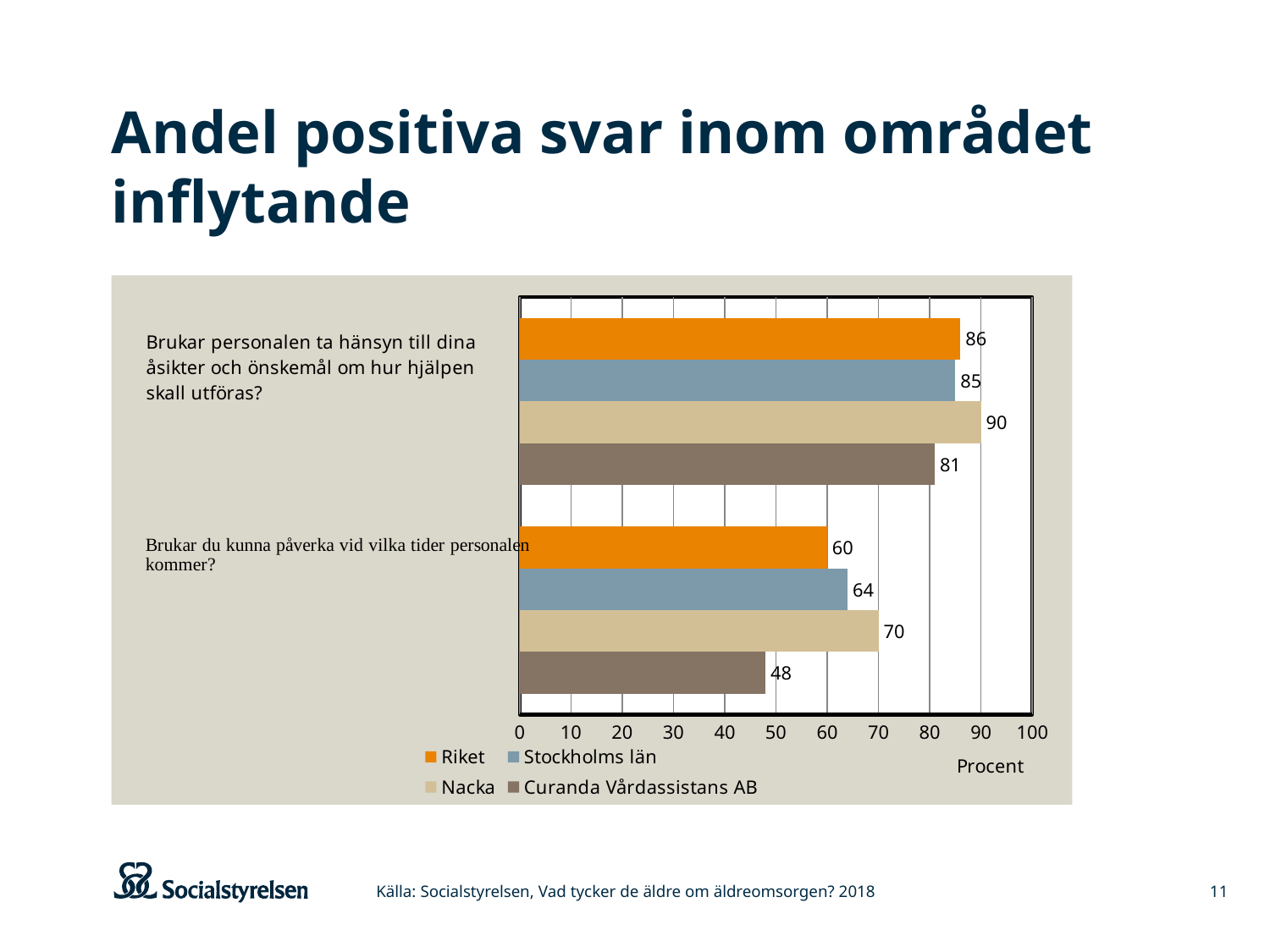
What is the difference between the Nacka and Curanda Vårdassistans AB values on the question "Brukar du kunna påverka vid vilka tider personalen kommer?"? 22 Which is larger on the question "Brukar personalen ta hänsyn till dina åsikter och önskemål om hur hjälpen skall utföras?": Riket or Stockholms län? Riket Which series has the highest value on the question "Brukar du kunna påverka vid vilka tider personalen kommer?"? Nacka What is the difference between the Riket values for the two questions? 26 What kind of chart is shown on the slide? Bar chart What is the value for Nacka on the question "Brukar personalen ta hänsyn till dina åsikter och önskemål om hur hjälpen skall utföras?"? 90 What is the value for Curanda Vårdassistans AB on the question "Brukar du kunna påverka vid vilka tider personalen kommer?"? 48 What is the value for Stockholms län on the question "Brukar personalen ta hänsyn till dina åsikter och önskemål om hur hjälpen skall utföras?"? 85 What is the label of the horizontal axis? Procent What is the value for Riket on the question "Brukar du kunna påverka vid vilka tider personalen kommer?"? 60 How many series does the legend list? 4 Which series has the lowest value on the question "Brukar personalen ta hänsyn till dina åsikter och önskemål om hur hjälpen skall utföras?"? Curanda Vårdassistans AB